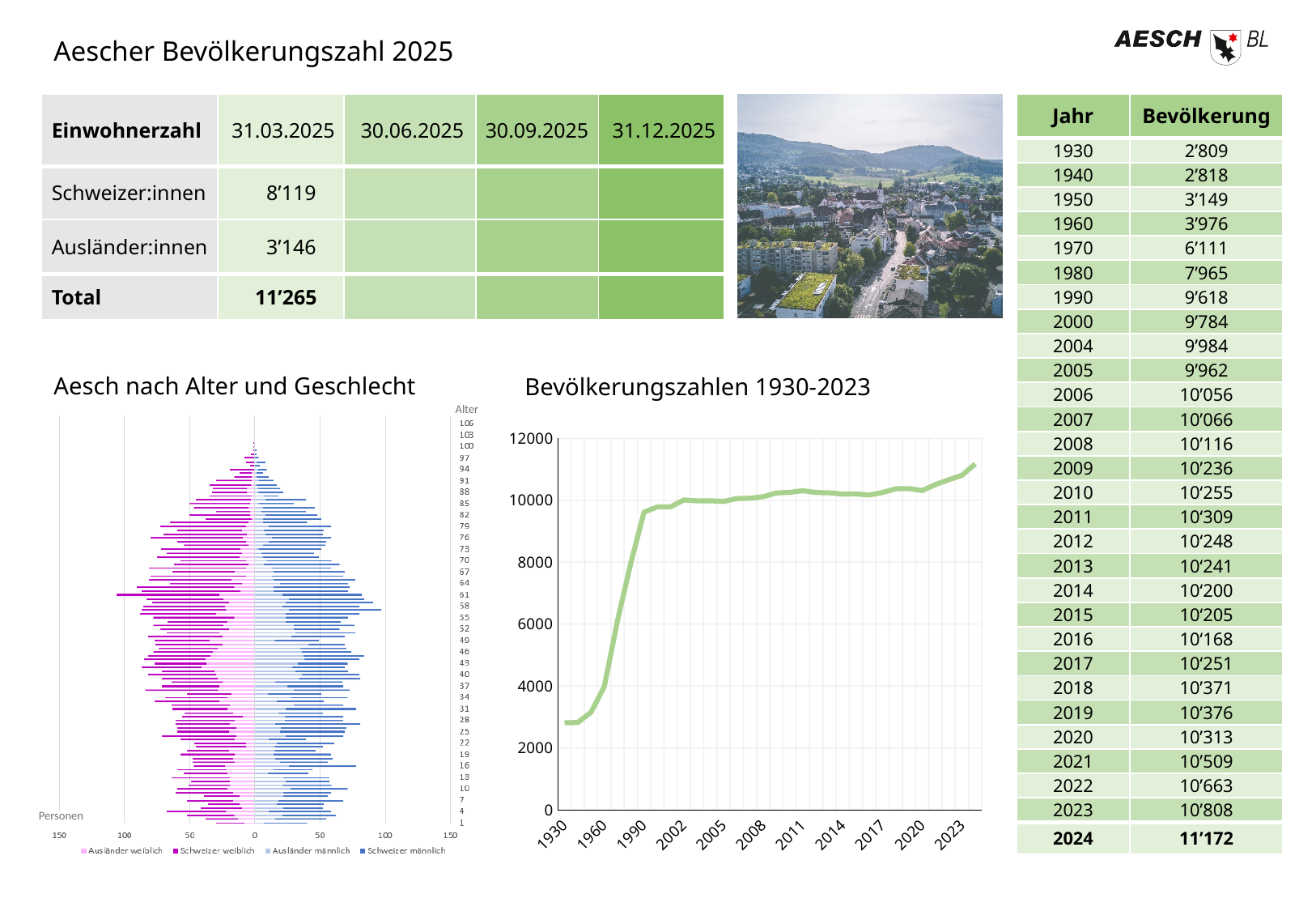
In the chart "Bevölkerungszahlen 1930-2023", is the value for 2023 greater or less than 12000? less In the chart "Bevölkerungszahlen 1930-2023", which year has the lowest value, 1930 or 1990? 1930 What kind of chart is "Aesch nach Alter und Geschlecht"? bar chart In the chart "Bevölkerungszahlen 1930-2023", is the value for 2023 greater or less than 10000? greater What kind of chart is "Bevölkerungszahlen 1930-2023"? line chart In the chart "Bevölkerungszahlen 1930-2023", is the value for 1930 greater or less than 4000? less In the chart "Aesch nach Alter und Geschlecht", what is the label of the horizontal axis? Personen How many series does the legend of the chart "Aesch nach Alter und Geschlecht" list? 4 How many year labels are shown on the x axis of the chart "Bevölkerungszahlen 1930-2023"? 11 In the chart "Bevölkerungszahlen 1930-2023", do the values generally rise or fall from 1930 to 2023? rise In the chart "Aesch nach Alter und Geschlecht", which series is shown in dark blue? Schweizer männlich